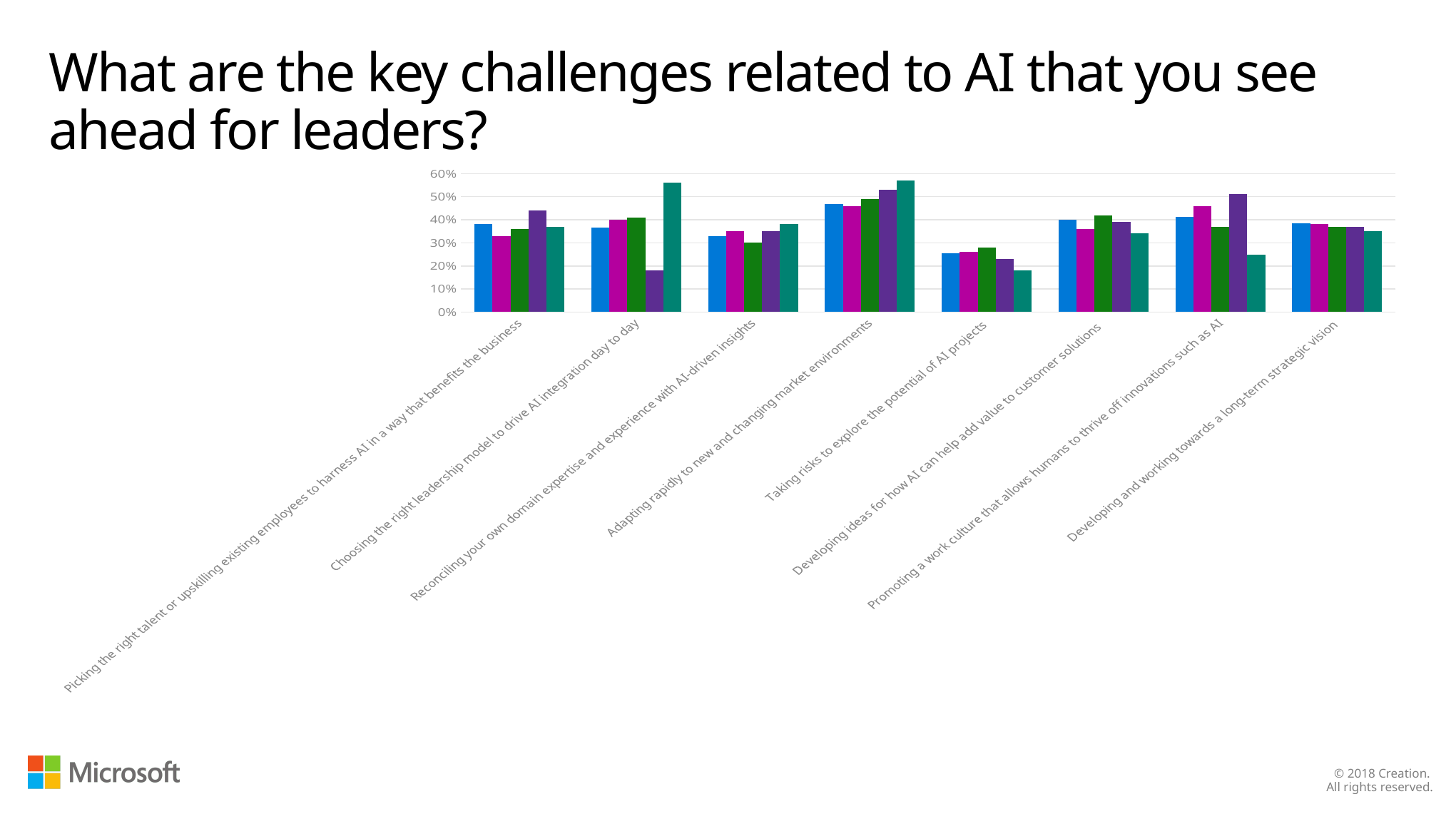
What kind of chart is shown on the slide? bar chart Is the teal bar for 'Promoting a work culture that allows humans to thrive off innovations such as AI' greater or less than 30%? less Is the teal bar for 'Taking risks to explore the potential of AI projects' greater or less than 20%? less How many challenge categories are shown along the x axis? 8 Which coloured bar is the lowest for 'Promoting a work culture that allows humans to thrive off innovations such as AI'? teal Is the purple bar for 'Choosing the right leadership model to drive AI integration day to day' greater or less than 20%? less Which is larger: the blue bar for 'Adapting rapidly to new and changing market environments' or the blue bar for 'Taking risks to explore the potential of AI projects'? Adapting rapidly to new and changing market environments Which coloured bar is the highest for 'Choosing the right leadership model to drive AI integration day to day'? teal How many bars (series) are plotted for each challenge category? 5 What is the highest value shown on the y axis? 60%